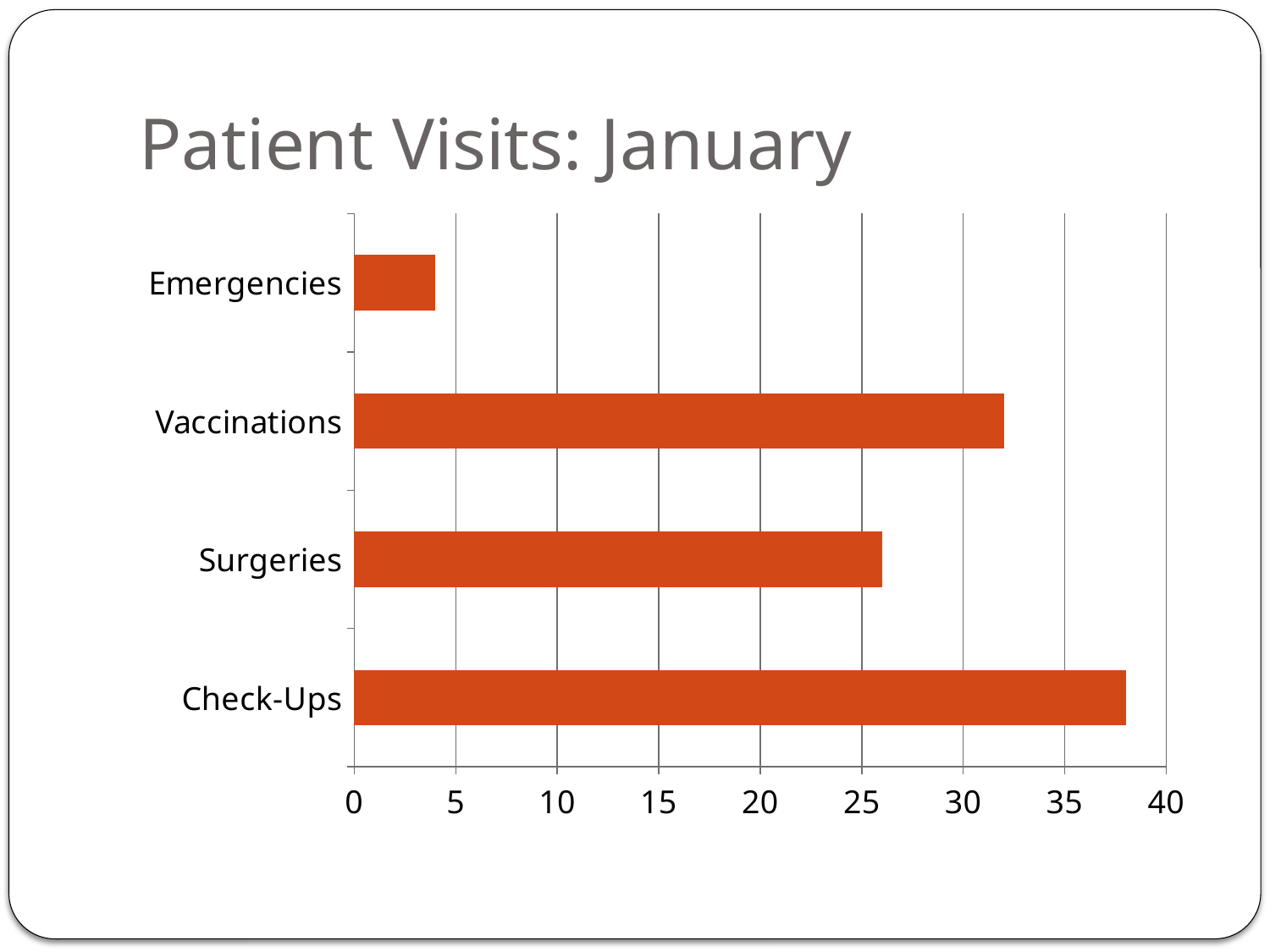
Which category has the lowest value? Emergencies Is the value for Vaccinations greater or less than 30? greater What kind of chart is shown on the slide? bar chart Which is larger, the value for Vaccinations or the value for Surgeries? Vaccinations How many categories are shown in the chart? 4 What is the maximum value shown on the horizontal axis? 40 Which is larger, the value for Check-Ups or the value for Vaccinations? Check-Ups Is the value for Check-Ups greater or less than 35? greater Which category has the highest value? Check-Ups Is the value for Surgeries greater or less than 30? less What is the title of the chart? Patient Visits: January